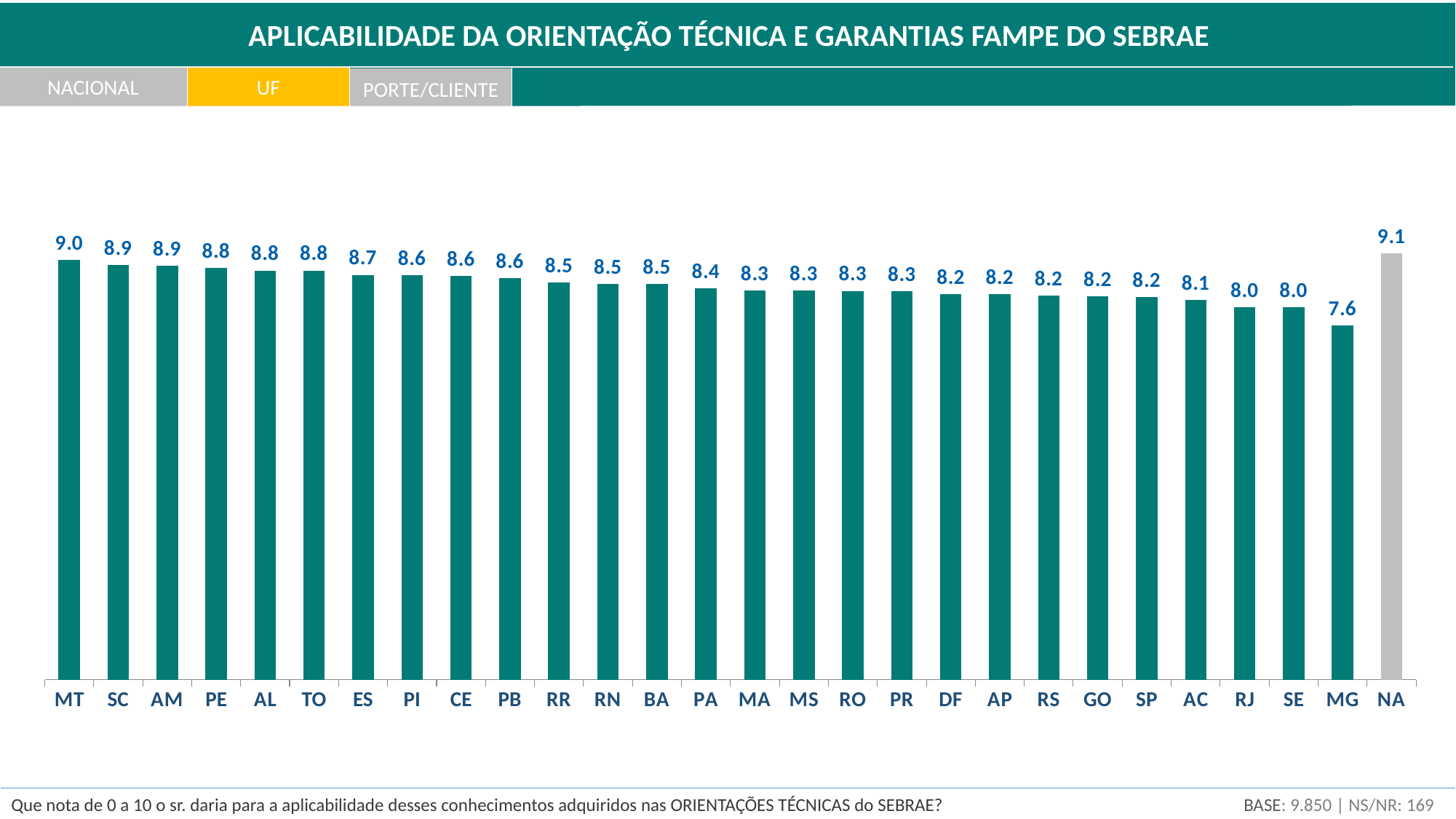
What is the value for MT? 9.0 How many categories are shown on the x axis? 28 Which is larger, the value for ES or the value for AC? ES What is the value for MG? 7.6 What is the value for NA? 9.1 What is the title of the chart? APLICABILIDADE DA ORIENTAÇÃO TÉCNICA E GARANTIAS FAMPE DO SEBRAE What is the difference between the values for NA and RJ? 1.1 What is the difference between the values for MT and MG? 1.4 Which category has the lowest value? MG What is the value for PA? 8.4 What kind of chart is shown on the slide? Bar chart Which category has the highest value? NA